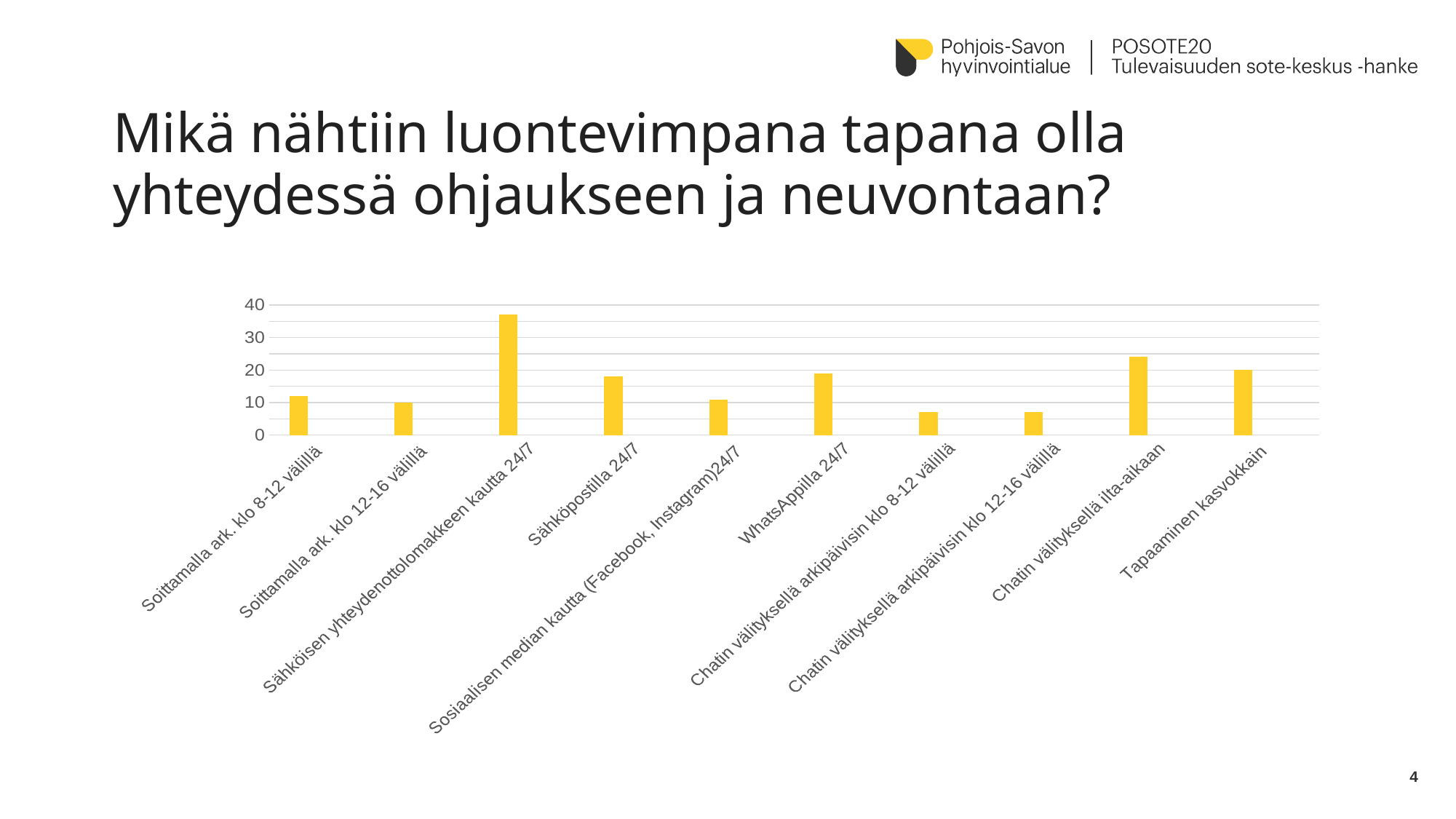
Is the value for Sähköisen yhteydenottolomakkeen kautta 24/7 greater or less than 30? greater Which is larger, the value for Chatin välityksellä ilta-aikaan or the value for Tapaaminen kasvokkain? Chatin välityksellä ilta-aikaan Which category has the highest value in the chart? Sähköisen yhteydenottolomakkeen kautta 24/7 Is the value for Sähköpostilla 24/7 greater or less than 20? less Is the value for Chatin välityksellä ilta-aikaan greater or less than 20? greater What kind of chart is shown on the slide? bar chart What colour are the bars in the chart? yellow Which is larger, the value for Sähköpostilla 24/7 or the value for Sosiaalisen median kautta (Facebook, Instagram)24/7? Sähköpostilla 24/7 How many categories are shown on the x axis of the chart? 10 What is the highest value shown on the y axis of the chart? 40